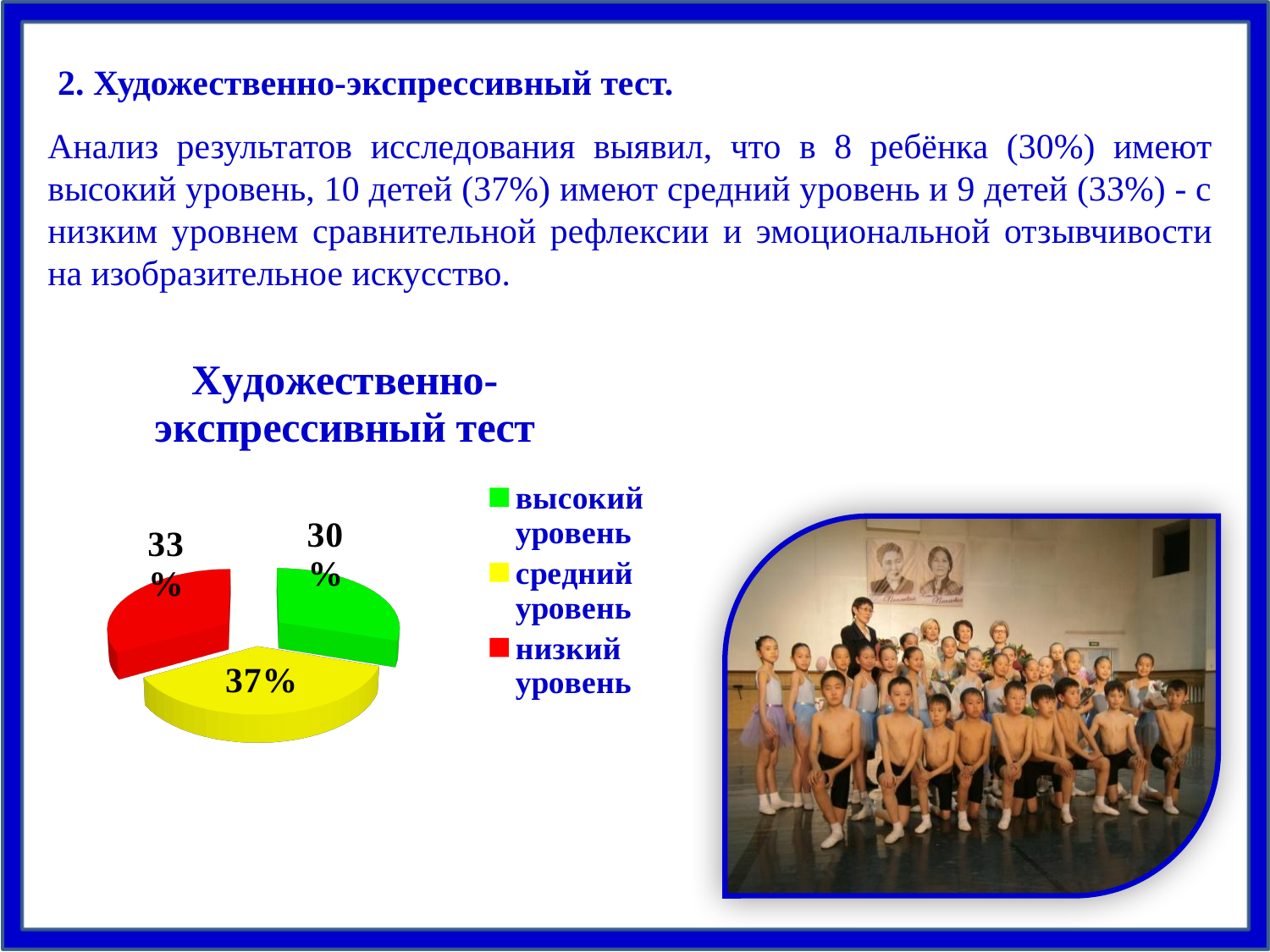
What percentage of the pie is labelled for высокий уровень? 30% Which slice is larger: средний уровень or низкий уровень? средний уровень What is the title of the chart? Художественно-экспрессивный тест What is the difference in percentage points between средний уровень and высокий уровень? 7 How many slices does the pie chart have? 3 Which level has the smallest slice of the pie? высокий уровень What kind of chart is shown on the slide? pie chart What percentage of the pie is labelled for низкий уровень? 33% Which level has the largest slice of the pie? средний уровень What percentage of the pie is labelled for средний уровень? 37% What colour is the slice for низкий уровень? red How many entries does the legend list? 3